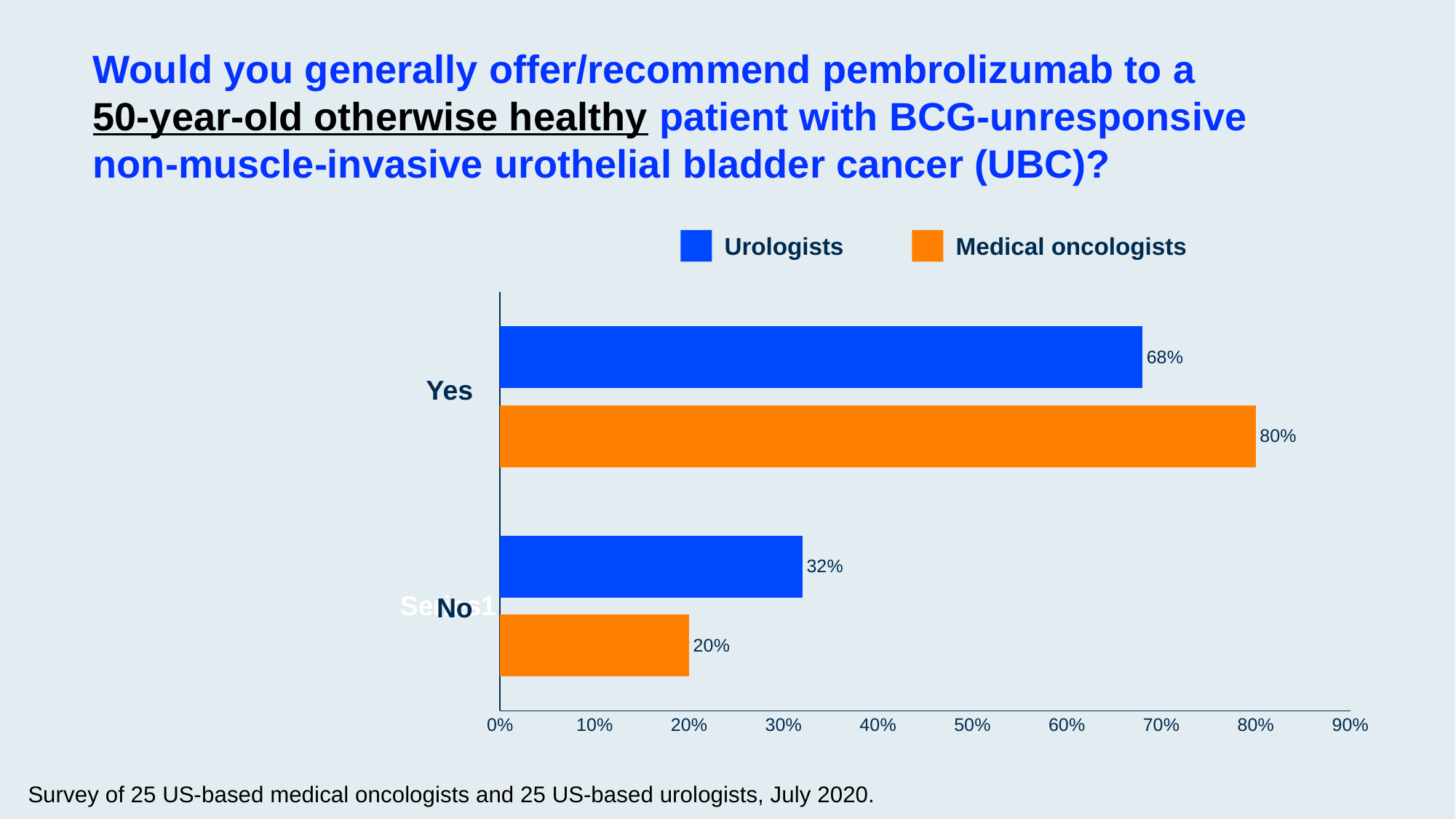
Which group has the higher percentage answering Yes, urologists or medical oncologists? Medical oncologists What is the difference between the medical oncologists' and urologists' Yes percentages? 12% What percentage of medical oncologists answered No? 20% What is the difference between the urologists' and medical oncologists' No percentages? 12% What percentage of urologists answered No? 32% Which bar shows the highest value on the chart? Medical oncologists, Yes (80%) Which bar shows the lowest value on the chart? Medical oncologists, No (20%) Which colour represents medical oncologists in the chart? Orange How many series does the legend list? 2 What percentage of medical oncologists answered Yes? 80% What percentage of urologists answered Yes? 68% What type of chart is shown on the slide? Bar chart